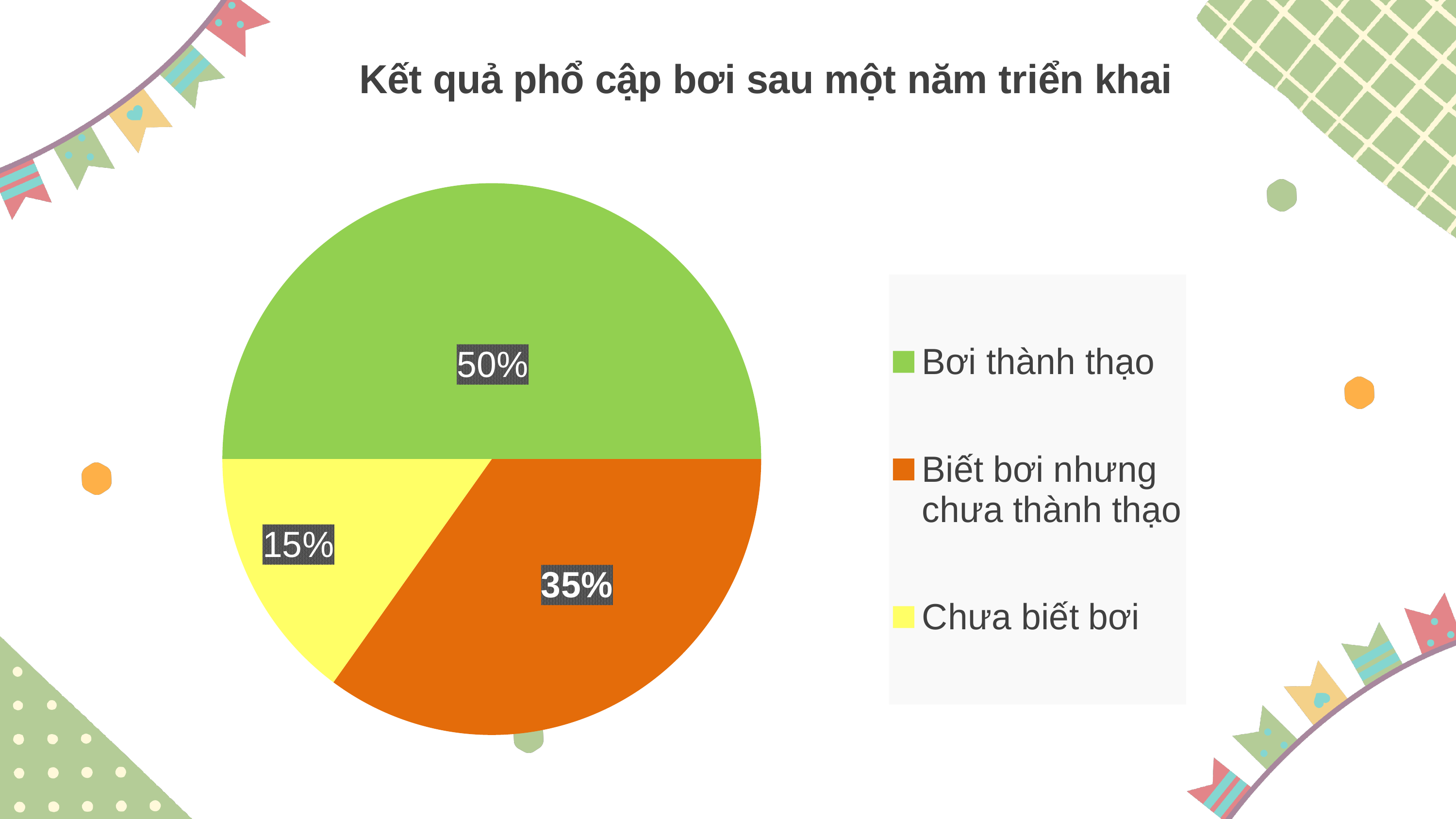
What is the difference between the values for Bơi thành thạo and Biết bơi nhưng chưa thành thạo? 15% Which is larger, the value for Biết bơi nhưng chưa thành thạo or the value for Chưa biết bơi? Biết bơi nhưng chưa thành thạo Which category has the smallest share of the pie? Chưa biết bơi What kind of chart is shown on the slide? pie chart What is the difference between the values for Biết bơi nhưng chưa thành thạo and Chưa biết bơi? 20% Which category has the largest share of the pie? Bơi thành thạo How many slices does the pie chart have? 3 What is the value for Chưa biết bơi? 15% What is the value for Bơi thành thạo? 50% What colour is the slice for Chưa biết bơi? yellow What is the title of the chart? Kết quả phổ cập bơi sau một năm triển khai What is the value for Biết bơi nhưng chưa thành thạo? 35%